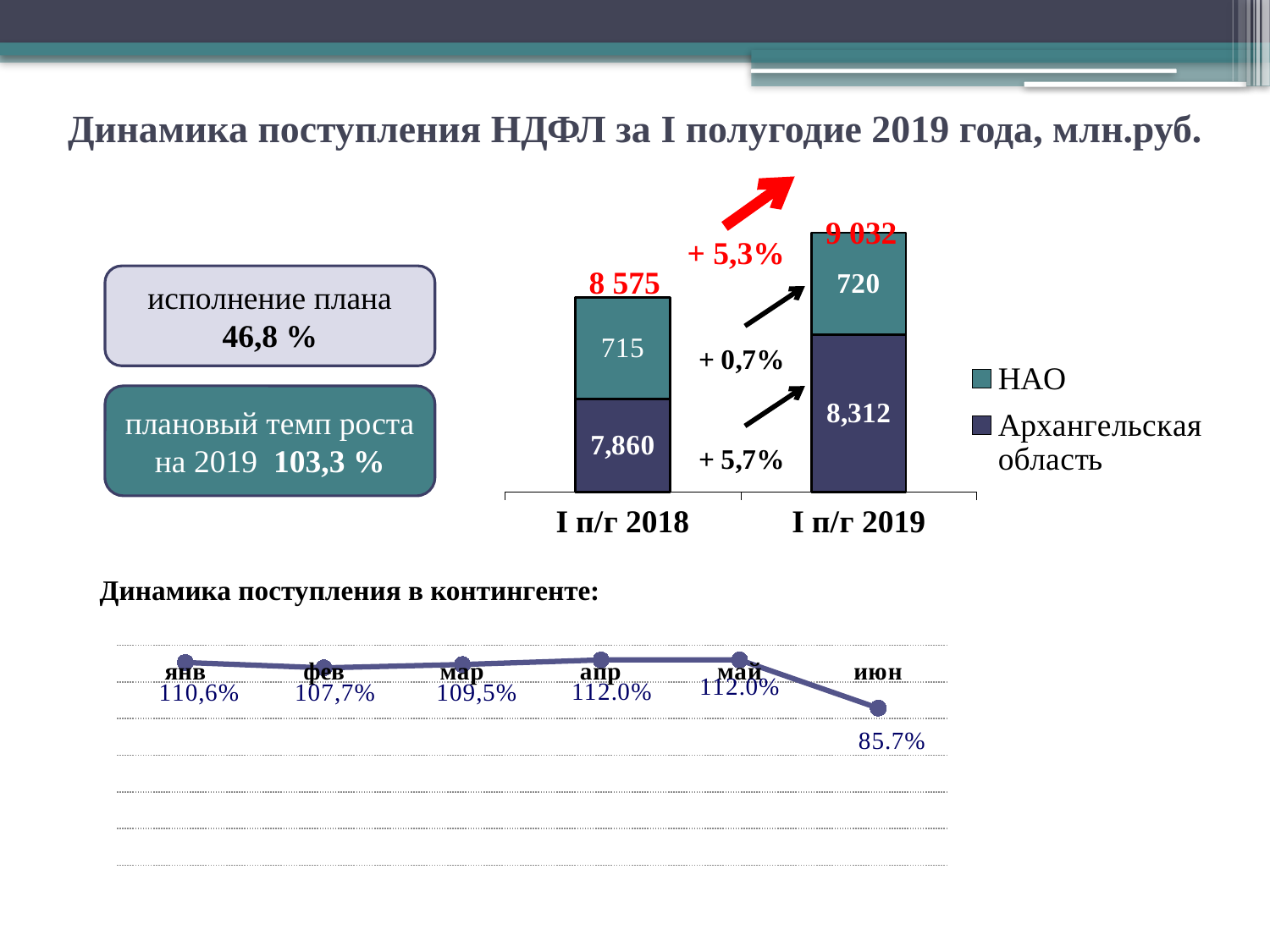
In the stacked bar chart at the top, what is the total of the I п/г 2019 bar? 9 032 In the stacked bar chart at the top, what is the value for Архангельская область in I п/г 2019? 8,312 What kind of chart is the one titled 'Динамика поступления в контингенте'? line chart In the stacked bar chart at the top, which is larger: Архангельская область in I п/г 2018 or in I п/г 2019? I п/г 2019 In the stacked bar chart at the top, how many series does the legend list? 2 In the line chart 'Динамика поступления в контингенте', what is the value for янв? 110,6% In the stacked bar chart at the top, what is the total of the I п/г 2018 bar? 8 575 In the stacked bar chart at the top, what percentage growth is shown between the totals of I п/г 2018 and I п/г 2019? + 5,3% In the line chart 'Динамика поступления в контингенте', how many months are plotted? 6 In the line chart 'Динамика поступления в контингенте', what is the value for мар? 109,5% In the line chart 'Динамика поступления в контингенте', which month has the lowest value? июн In the stacked bar chart at the top, what is the value for НАО in I п/г 2018? 715